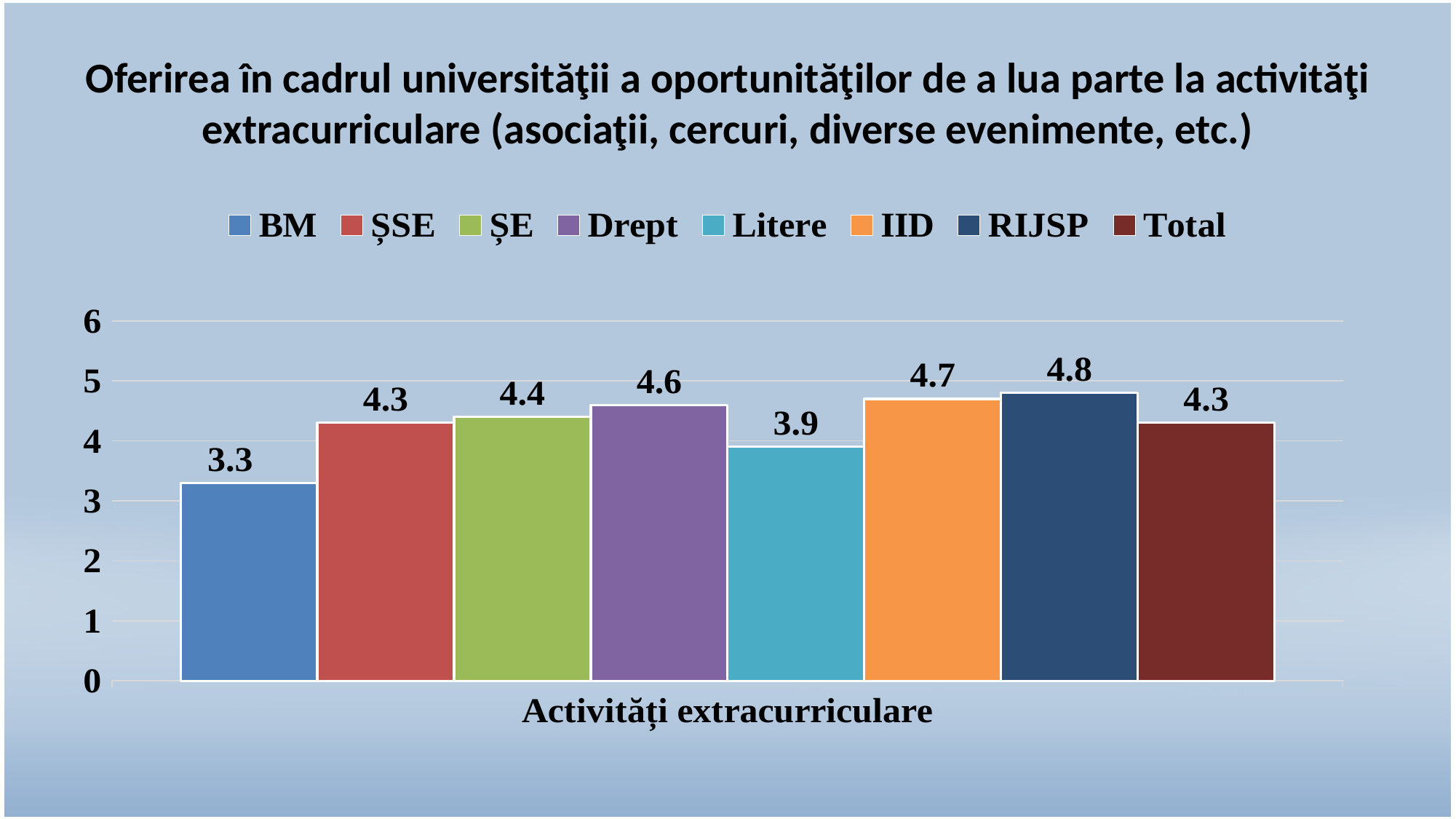
What is the difference between the values for RIJSP and BM? 1.5 What is the value for Litere? 3.9 What is the x-axis label of the chart? Activități extracurriculare What is the value for BM? 3.3 Which is larger, the value for ȘE or the value for Litere? ȘE Is the value for Litere greater or less than 3? greater What is the difference between the values for IID and Litere? 0.8 What is the value for Drept? 4.6 Which series has the lowest value? BM How many series does the legend list? 8 Which series has the highest value? RIJSP What kind of chart is shown on the slide? bar chart